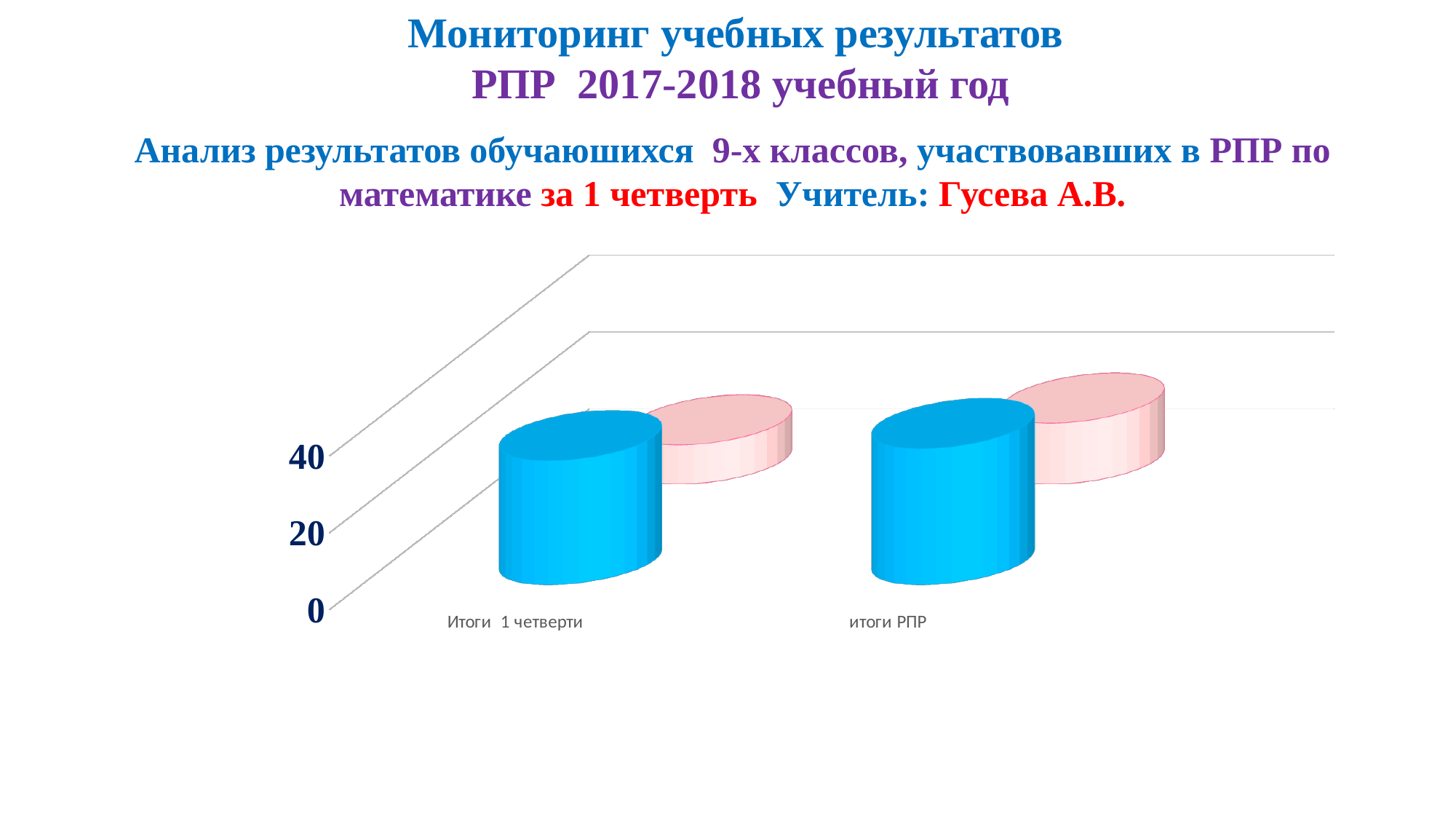
For the category "Итоги 1 четверти", which bar is taller, the blue one or the pink one? the blue one How many categories are shown on the x axis of the chart? 2 Is the value of the blue bar for "Итоги 1 четверти" greater or less than 20? greater Is the value of the blue bar for "итоги РПР" greater or less than 20? greater What are the two category labels on the x axis of the chart? Итоги 1 четверти, итоги РПР For the category "итоги РПР", which bar is taller, the blue one or the pink one? the blue one What is the highest tick value shown on the vertical axis of the chart? 40 What kind of chart is shown on the slide? bar chart What colours are the two series of bars in the chart? blue and pink